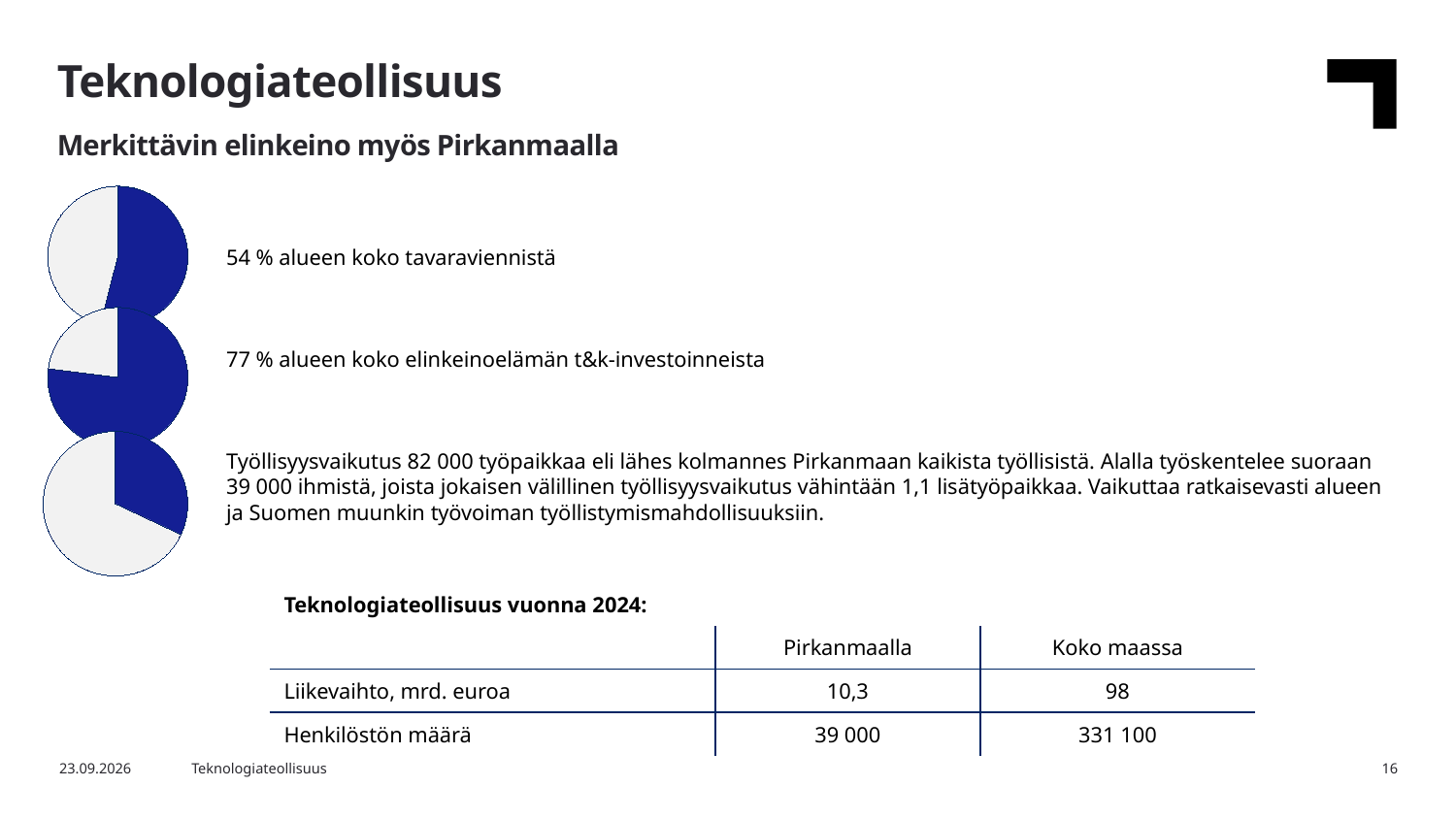
What colour is used for the highlighted slice in each pie chart? Dark blue What kind of charts are shown on the left side of the slide? Pie charts Which of the three pie charts has the largest dark blue slice? The middle one Is the dark blue slice in the middle pie chart larger or smaller than half of the pie? Larger What share of the region's business R&D investments does the middle pie chart represent, according to the text beside it? 77 % Which of the three pie charts has the smallest dark blue slice? The bottom one What is the difference in percentage points between the shares shown for the middle pie chart (77 %) and the top pie chart (54 %)? 23 percentage points Which pie chart has the larger dark blue slice, the top one or the middle one? The middle one How many slices does the top pie chart have? 2 What share of the region's total goods exports does the top pie chart represent, according to the text beside it? 54 % How many pie charts are on the slide? 3 Is the dark blue slice in the bottom pie chart larger or smaller than half of the pie? Smaller